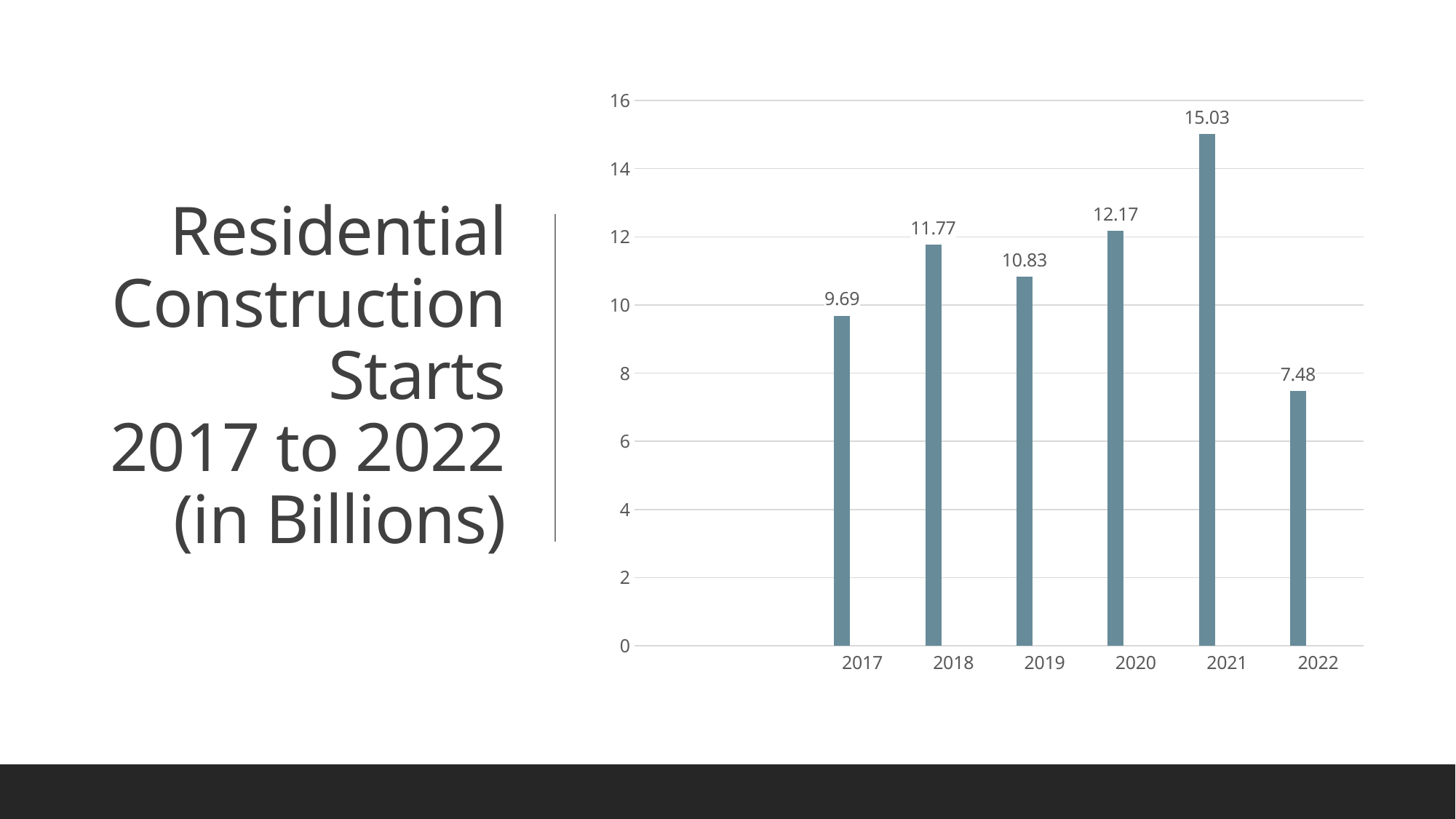
What is the value for 2017? 9.69 How many years are shown on the chart? 6 What is the value for 2021? 15.03 What is the title of the slide? Residential Construction Starts 2017 to 2022 (in Billions) What is the value for 2022? 7.48 Which year has the lowest value? 2022 Which is larger, the value for 2018 or the value for 2020? 2020 Is the value for 2019 greater or less than 10? greater What kind of chart is shown on the slide? Bar chart What is the difference between the values for 2018 and 2019? 0.94 What is the difference between the values for 2021 and 2022? 7.55 Which year has the highest value? 2021